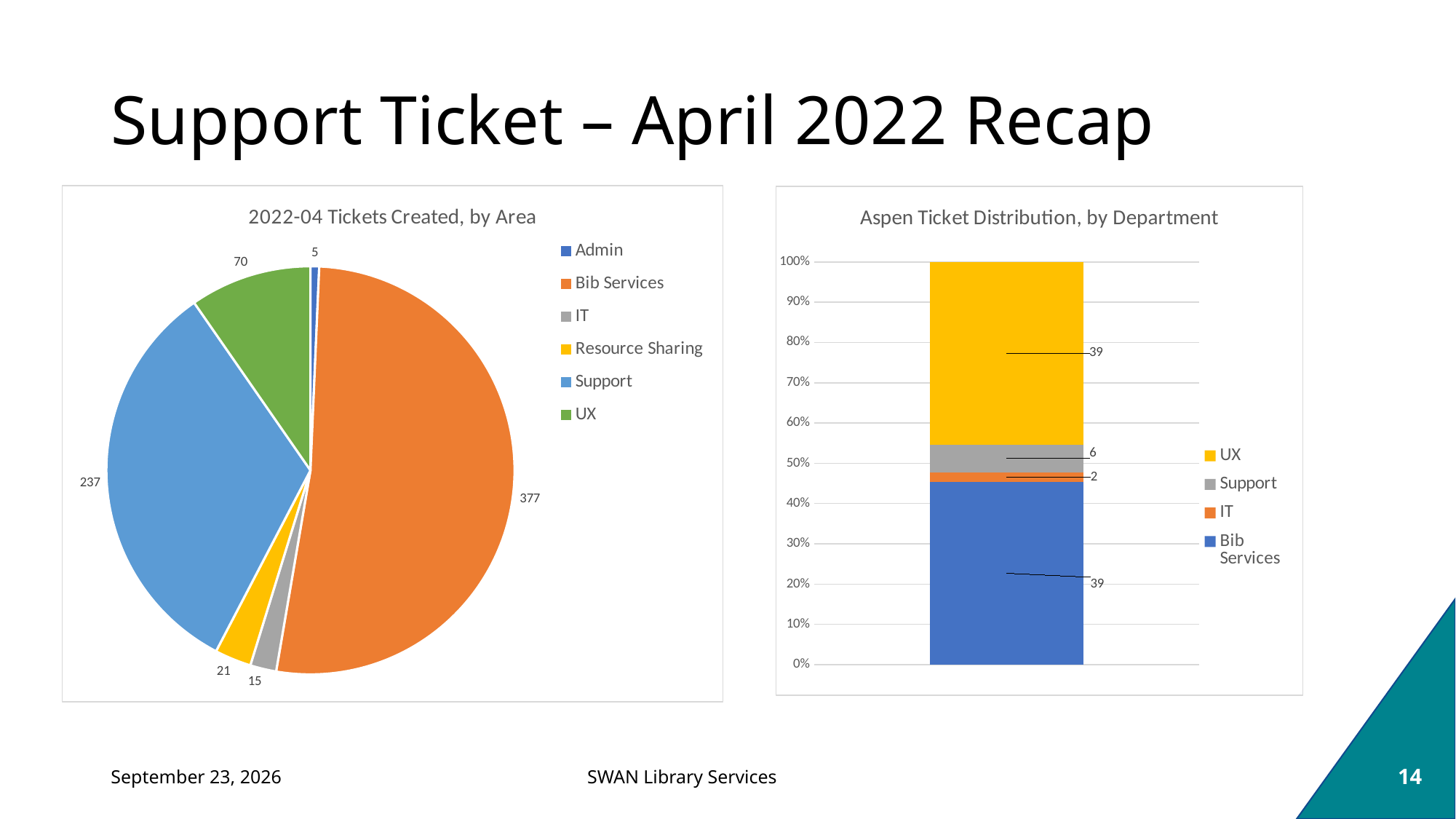
How many series does the legend of the 'Aspen Ticket Distribution, by Department' chart list? 4 In the '2022-04 Tickets Created, by Area' chart, which area has the fewest tickets? Admin In the '2022-04 Tickets Created, by Area' chart, what is the difference between the Bib Services and Support ticket counts? 140 In the '2022-04 Tickets Created, by Area' chart, how many tickets were created for Support? 237 What type of chart is 'Aspen Ticket Distribution, by Department'? Stacked bar chart In the '2022-04 Tickets Created, by Area' chart, which has more tickets, Resource Sharing or IT? Resource Sharing How many areas are shown in the '2022-04 Tickets Created, by Area' pie chart? 6 In the 'Aspen Ticket Distribution, by Department' chart, what is the total of all segments in the stacked bar? 86 In the '2022-04 Tickets Created, by Area' chart, what share of all tickets does Bib Services represent? 52% In the 'Aspen Ticket Distribution, by Department' chart, what is the value for IT? 2 In the '2022-04 Tickets Created, by Area' chart, how many tickets were created for Bib Services? 377 In the '2022-04 Tickets Created, by Area' chart, which area has the most tickets? Bib Services